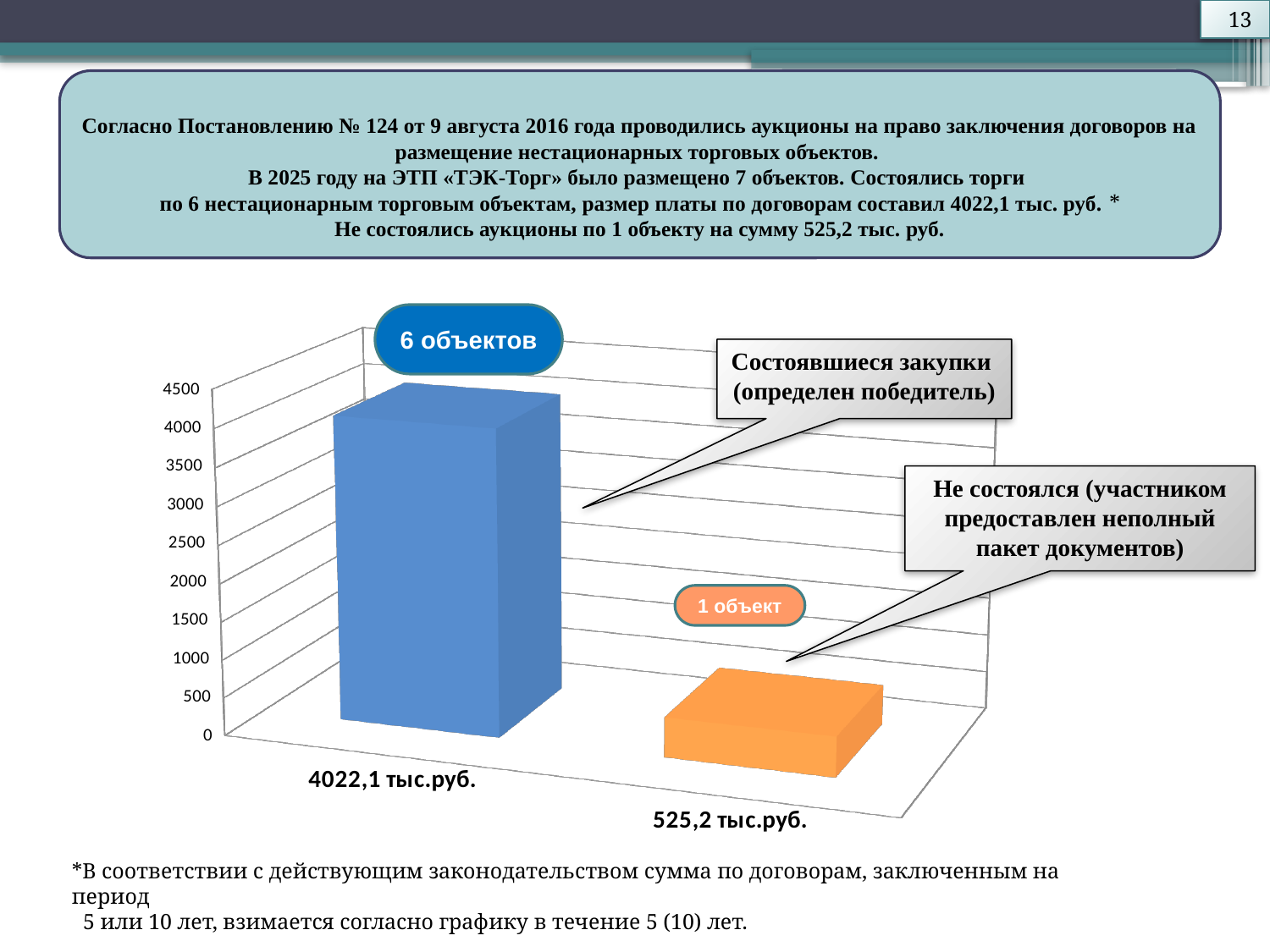
Which bar is the highest in the chart? Состоявшиеся закупки (4022,1 тыс.руб.) How many objects does the orange bar represent, according to its label? 1 объект What kind of chart is shown on the slide? bar chart How many objects does the blue bar represent, according to its label? 6 объектов What is the value shown for the orange bar (Не состоялся)? 525,2 тыс.руб. What is the difference between the values of the blue bar and the orange bar? 3496,9 тыс.руб. What is the value shown for the blue bar (Состоявшиеся закупки)? 4022,1 тыс.руб. What is the highest tick value shown on the vertical axis? 4500 Which bar is the lowest in the chart? Не состоялся (525,2 тыс.руб.) How many bars are plotted in the chart? 2 Which is larger: the value for Состоявшиеся закупки or the value for Не состоялся? Состоявшиеся закупки Is the value of the orange bar greater or less than 1000? less